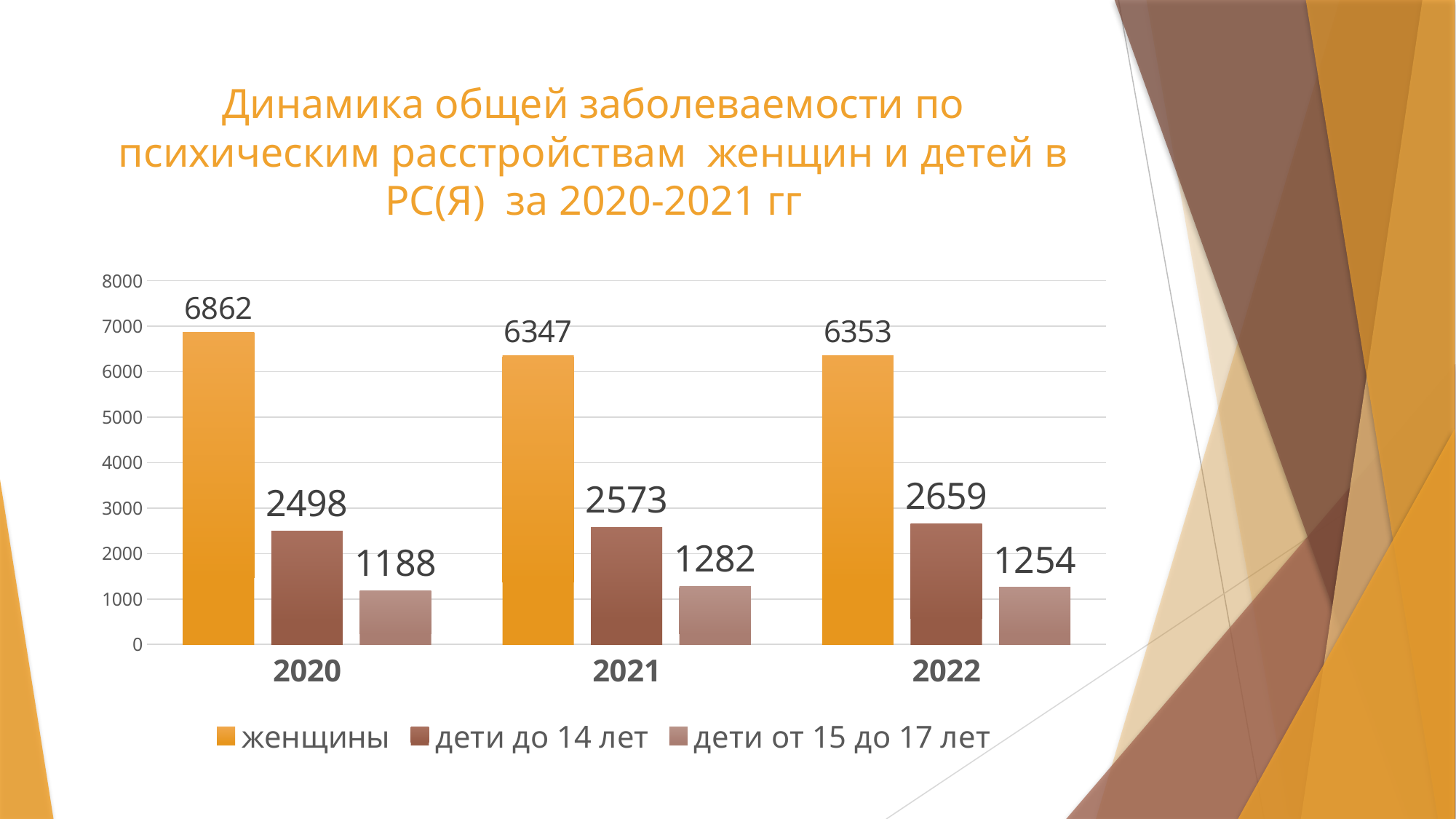
How many years are shown on the x axis? 3 What is the value for дети от 15 до 17 лет in 2022? 1254 What is the value for дети до 14 лет in 2021? 2573 Which is larger: дети до 14 лет in 2022 or дети до 14 лет in 2020? дети до 14 лет in 2022 What is the value for женщины in 2020? 6862 What kind of chart is shown on the slide? bar chart What is the difference between the женщины values for 2020 and 2021? 515 How many series does the legend list? 3 In which year is the value for дети от 15 до 17 лет lowest? 2020 Does the value for дети до 14 лет rise or fall from 2020 to 2022? rise Is the value for дети до 14 лет in 2021 greater or less than 3000? less In which year is the value for женщины highest? 2020